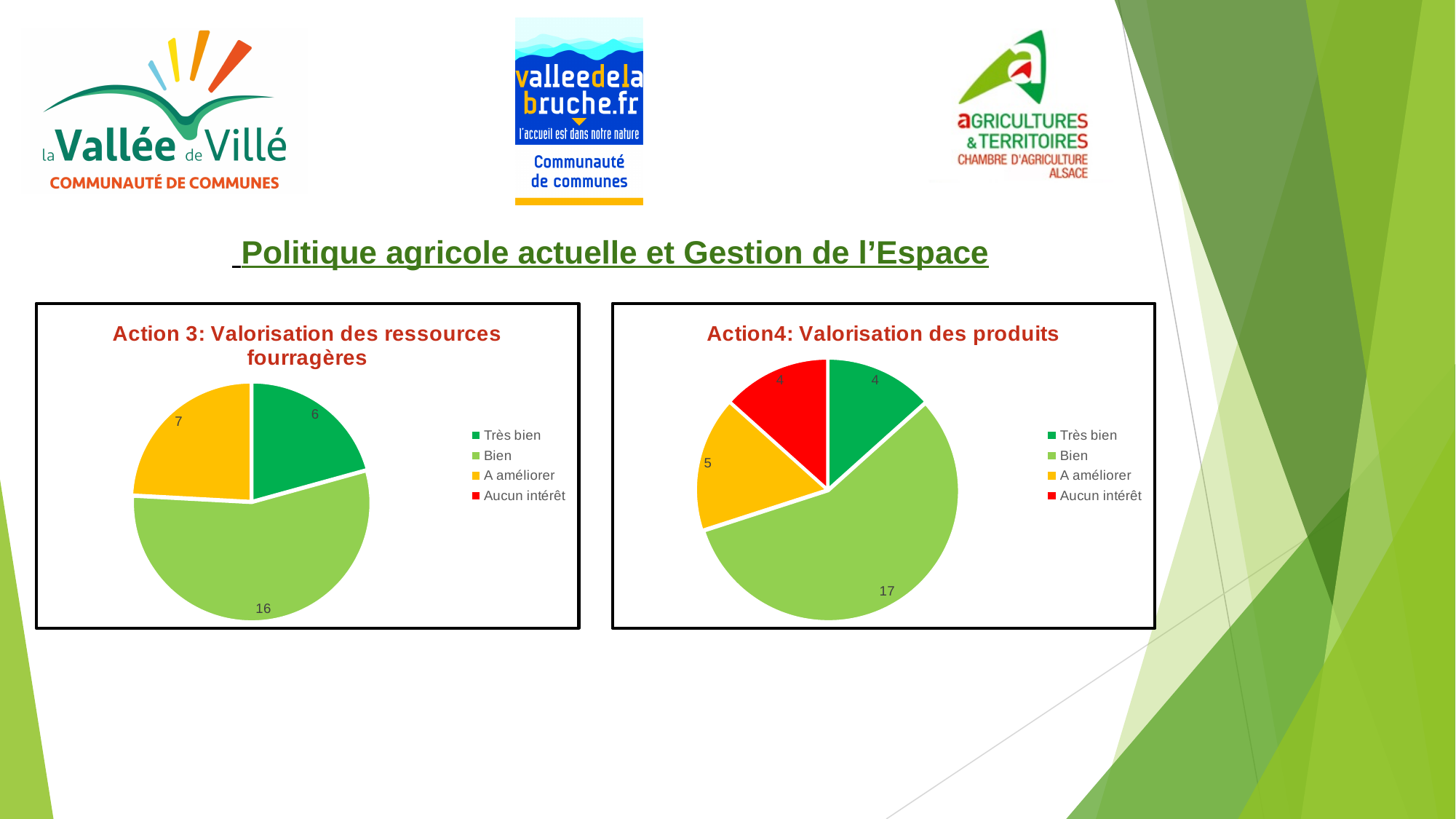
How many entries does the legend of the 'Action 3: Valorisation des ressources fourragères' chart list? 4 In the 'Action 3: Valorisation des ressources fourragères' chart, what is the value for 'Bien'? 16 In the 'Action4: Valorisation des produits' chart, what is the value for 'Bien'? 17 In the 'Action4: Valorisation des produits' chart, what is the total of all slices? 30 In the 'Action 3: Valorisation des ressources fourragères' chart, what is the difference between 'Bien' and 'A améliorer'? 9 What type of chart is 'Action4: Valorisation des produits'? Pie chart In the 'Action 3: Valorisation des ressources fourragères' chart, which category has the largest slice? Bien In the 'Action4: Valorisation des produits' chart, what is the value for 'A améliorer'? 5 In the 'Action4: Valorisation des produits' chart, what is the value for 'Aucun intérêt'? 4 In the 'Action4: Valorisation des produits' chart, which is larger, 'A améliorer' or 'Très bien'? A améliorer In the 'Action 3: Valorisation des ressources fourragères' chart, what is the value for 'Très bien'? 6 In the 'Action 3: Valorisation des ressources fourragères' chart, what is the value for 'A améliorer'? 7